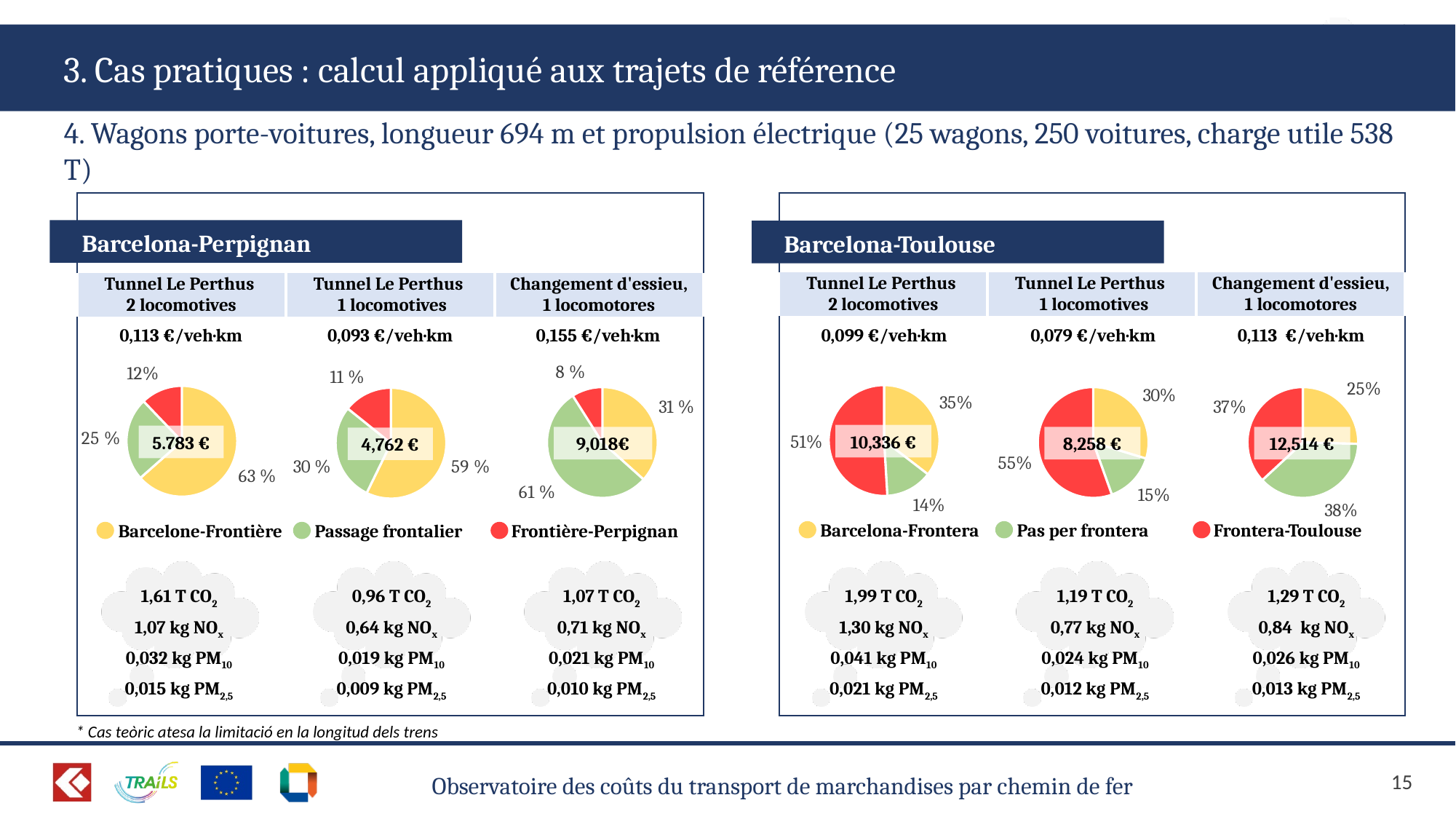
In the Barcelona-Toulouse 'Tunnel Le Perthus 2 locomotives' pie chart, what is the difference between the Frontera-Toulouse share and the Barcelona-Frontera share? 16% What type of chart is used in the Barcelona-Toulouse panel? Pie chart In the Barcelona-Toulouse 'Changement d'essieu, 1 locomotores' pie chart, what share is labelled for Pas per frontera? 38% In the Barcelona-Perpignan 'Tunnel Le Perthus 1 locomotives' pie chart, what share is labelled for Passage frontalier? 30 % In the Barcelona-Perpignan 'Changement d'essieu, 1 locomotores' pie chart, which segment is the smallest? Frontière-Perpignan In the Barcelona-Perpignan 'Tunnel Le Perthus 2 locomotives' pie chart, what share is labelled for Barcelone-Frontière? 63 % In the Barcelona-Toulouse 'Tunnel Le Perthus 1 locomotives' pie chart, which segment is the smallest? Pas per frontera In the Barcelona-Perpignan 'Tunnel Le Perthus 2 locomotives' pie chart, which is larger: the Passage frontalier share or the Frontière-Perpignan share? Passage frontalier How many segments does each pie chart on the slide have? 3 What total value is shown in the centre of the Barcelona-Toulouse 'Changement d'essieu, 1 locomotores' pie chart? 12,514 € In the Barcelona-Perpignan 'Changement d'essieu, 1 locomotores' pie chart, which segment is the largest? Passage frontalier